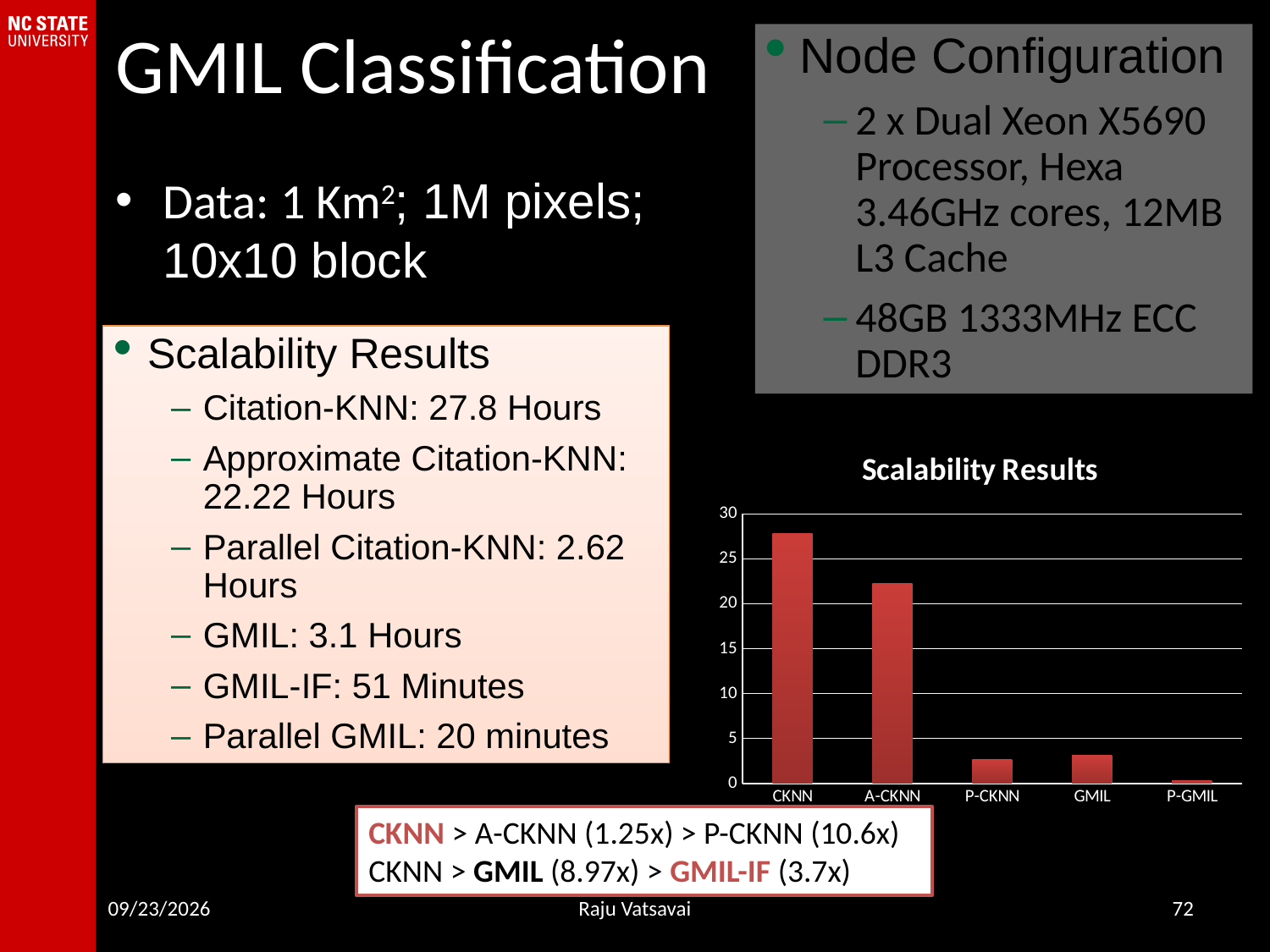
What kind of chart is shown under the title "Scalability Results"? bar chart In the Scalability Results chart, which is larger, the bar for A-CKNN or the bar for GMIL? A-CKNN In the Scalability Results chart, is the value for CKNN greater or less than 25? greater In the Scalability Results chart, is the value for P-CKNN greater or less than 5? less In the Scalability Results chart, is the value for GMIL greater or less than 5? less How many categories are plotted on the x axis of the Scalability Results chart? 5 Which category has the highest bar in the Scalability Results chart? CKNN In the Scalability Results chart, which is larger, the bar for CKNN or the bar for A-CKNN? CKNN Which category has the lowest bar in the Scalability Results chart? P-GMIL What is the title of the chart on the slide? Scalability Results